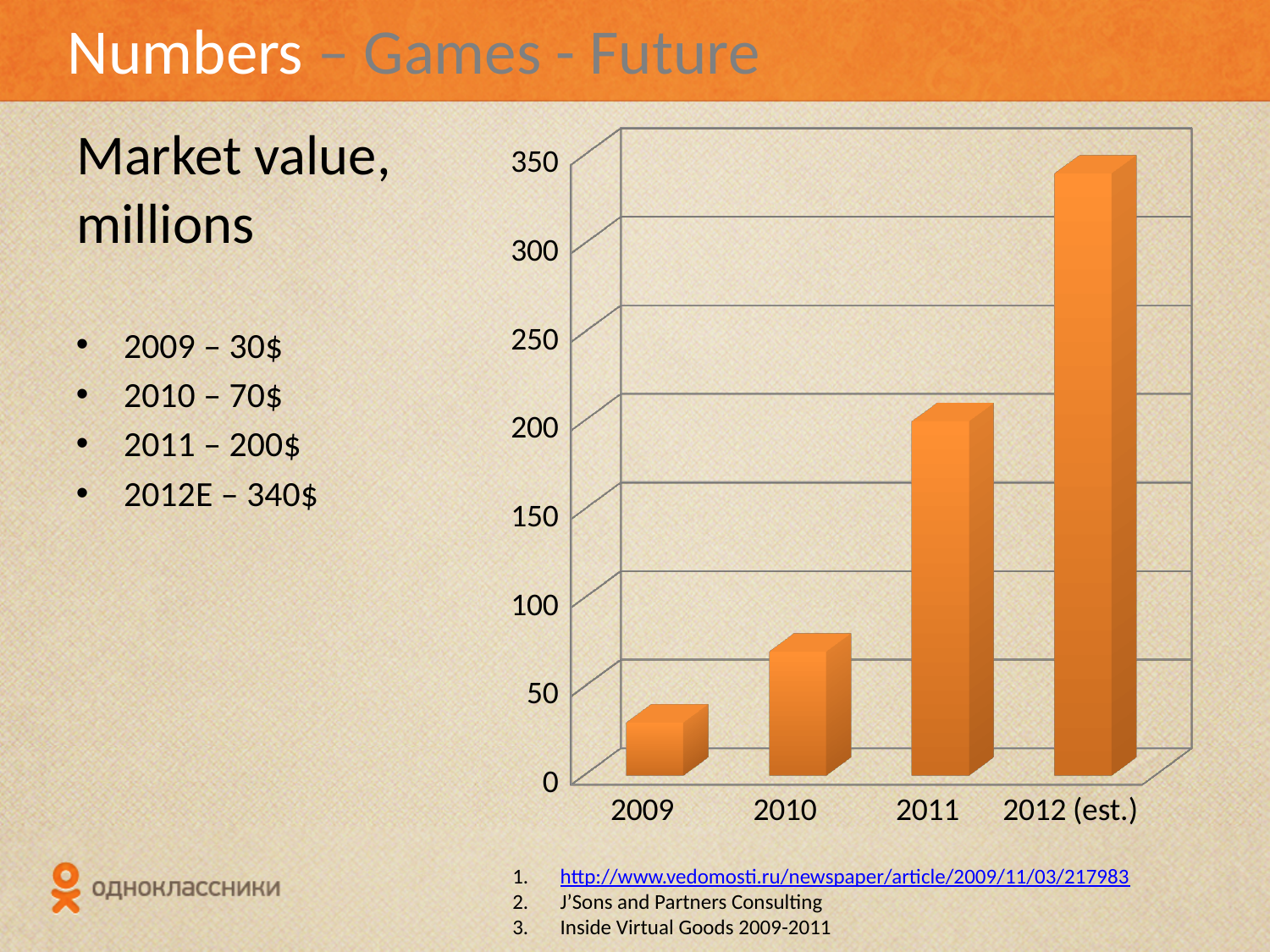
What type of chart is shown on the slide? bar chart What is the difference between the market value for 2011 and 2010 as given on the slide? 130$ Which is larger, the bar for 2010 or the bar for 2011? 2011 What is the market value for 2011 according to the slide? 200$ Is the value for 2012 (est.) greater or less than 300? greater What is the estimated market value for 2012 according to the slide? 340$ How many categories (years) are shown on the x axis of the chart? 4 Which year has the highest bar in the chart? 2012 (est.) What is the market value for 2009 according to the slide? 30$ Do the values rise or fall from 2009 to 2012 (est.)? rise Is the value for 2010 greater or less than 100? less Which year has the lowest bar in the chart? 2009